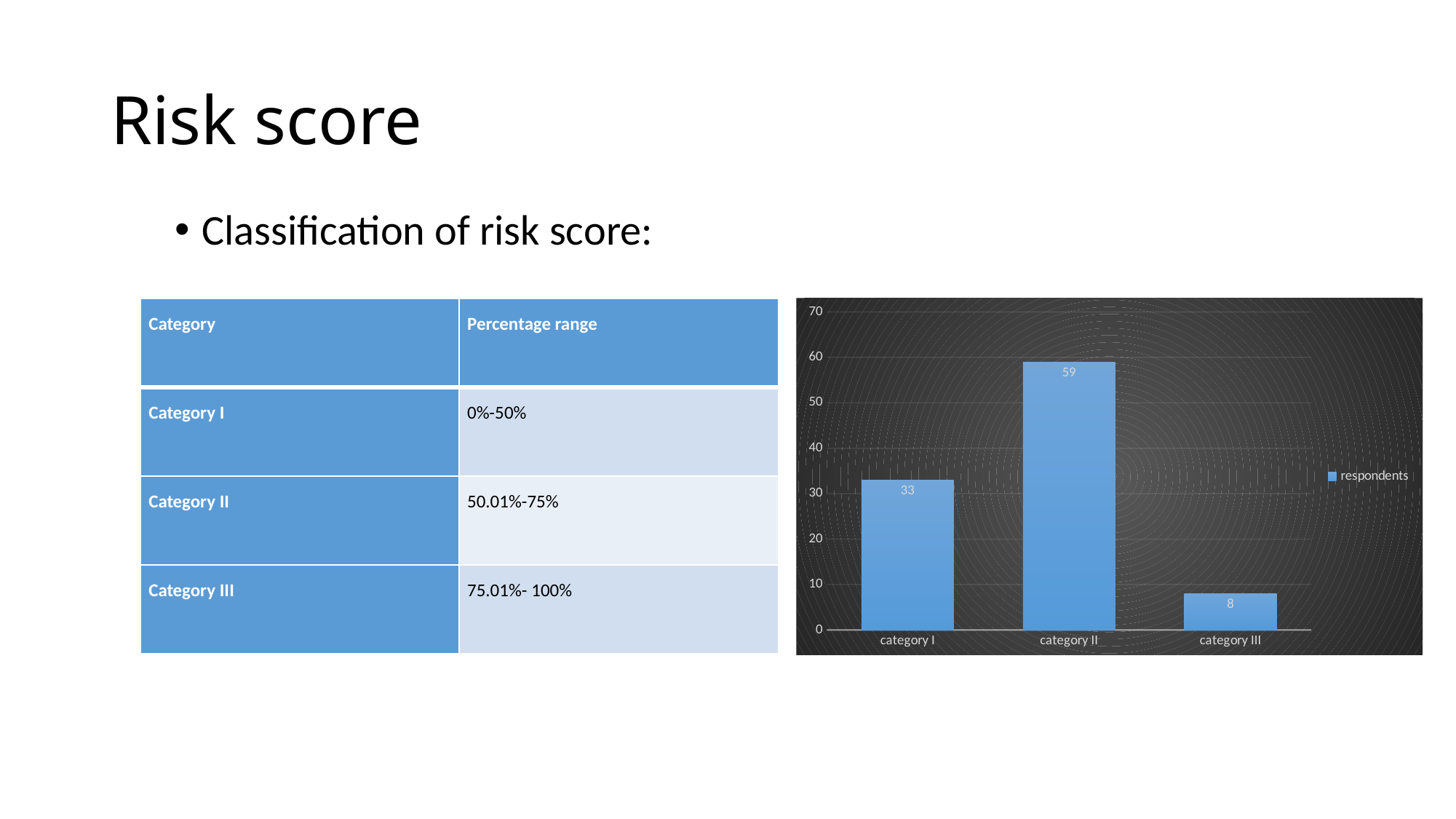
What kind of chart is shown on the slide? bar chart Which category has the lowest number of respondents? category III What is the number of respondents for category II? 59 What is the number of respondents for category III? 8 What is the difference in respondents between category II and category I? 26 What is the number of respondents for category I? 33 Which has more respondents, category I or category III? category I What is the difference in respondents between category I and category III? 25 Which category has the highest number of respondents? category II How many categories are shown on the x axis of the chart? 3 How many series does the chart legend list? 1 Is the value for category II greater or less than 50? greater